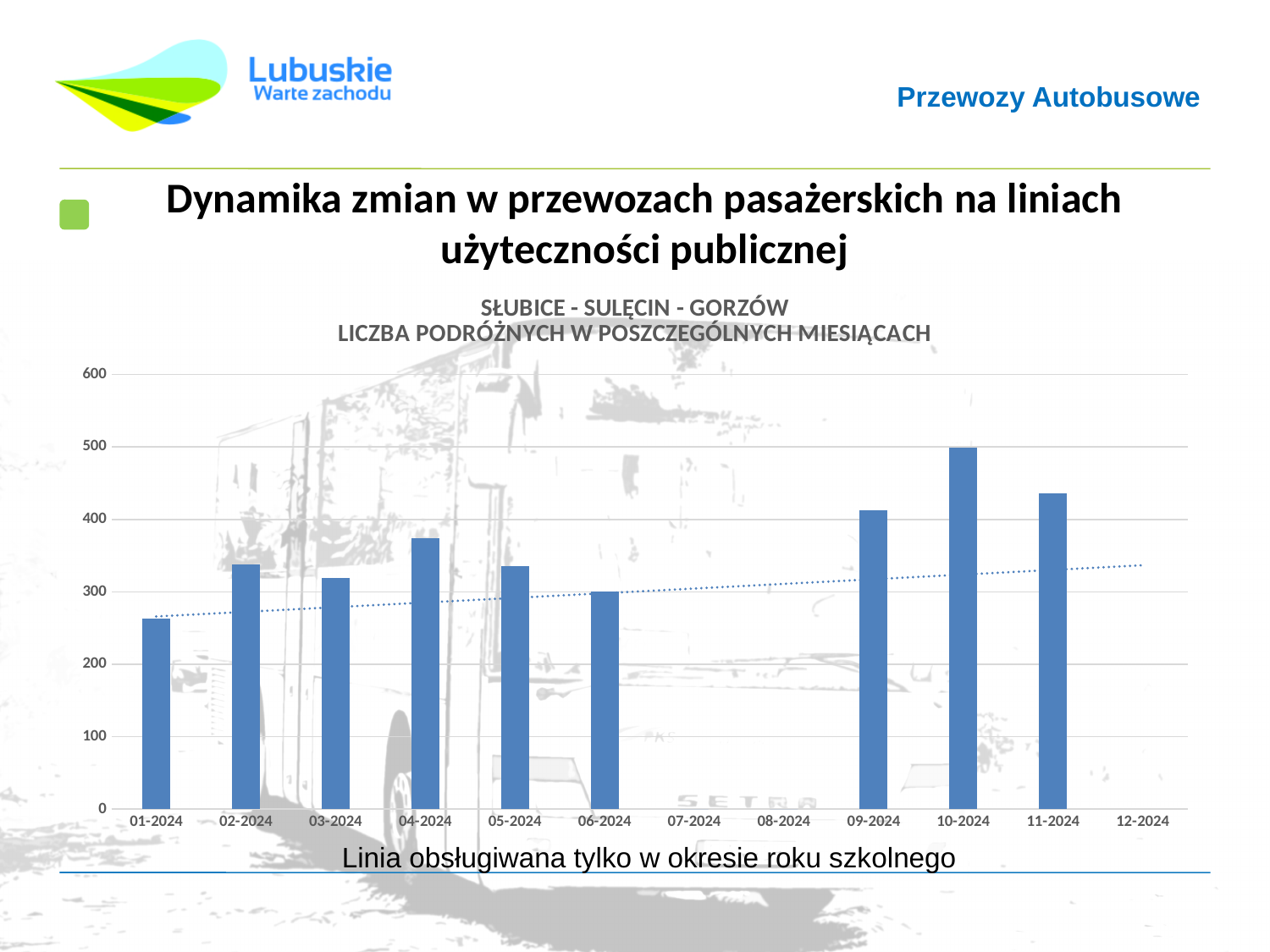
Among the months with a bar, which month has the lowest number of passengers? 01-2024 Which is larger, the value for 04-2024 or the value for 03-2024? 04-2024 Which month has the highest number of passengers? 10-2024 Is the value for 01-2024 greater or less than 300? less Is the value for 11-2024 greater or less than 400? greater How many months are labelled on the x axis? 12 Is the value for 04-2024 greater or less than 300? greater What kind of chart is shown on the slide? bar chart How many months have a bar plotted? 9 Does the dotted trend line rise or fall from left to right? rise Which is larger, the value for 10-2024 or the value for 11-2024? 10-2024